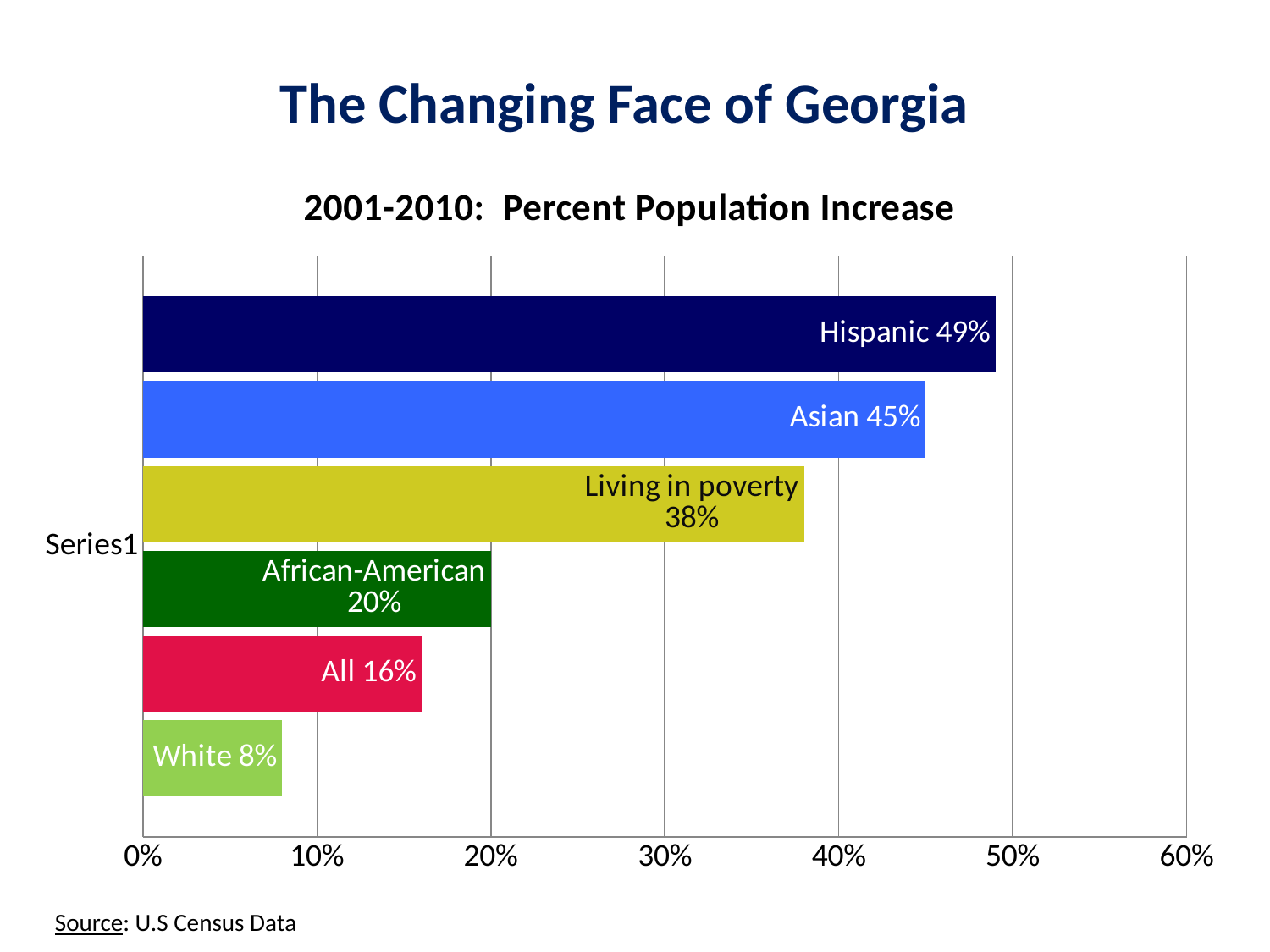
What is the title of the chart? 2001-2010: Percent Population Increase What is the difference between the Living in poverty and All percent population increases? 22% What kind of chart is shown on the slide? bar chart What is the percent population increase for African-American? 20% What is the percent population increase for White? 8% Which group has the lowest percent population increase? White How many bars are shown in the chart? 6 Which group has the highest percent population increase? Hispanic Is the value for Living in poverty greater or less than 40%? less What is the percent population increase for Hispanic? 49% Which is larger, the percent increase for Asian or for Living in poverty? Asian What is the difference between the Hispanic and Asian percent population increases? 4%